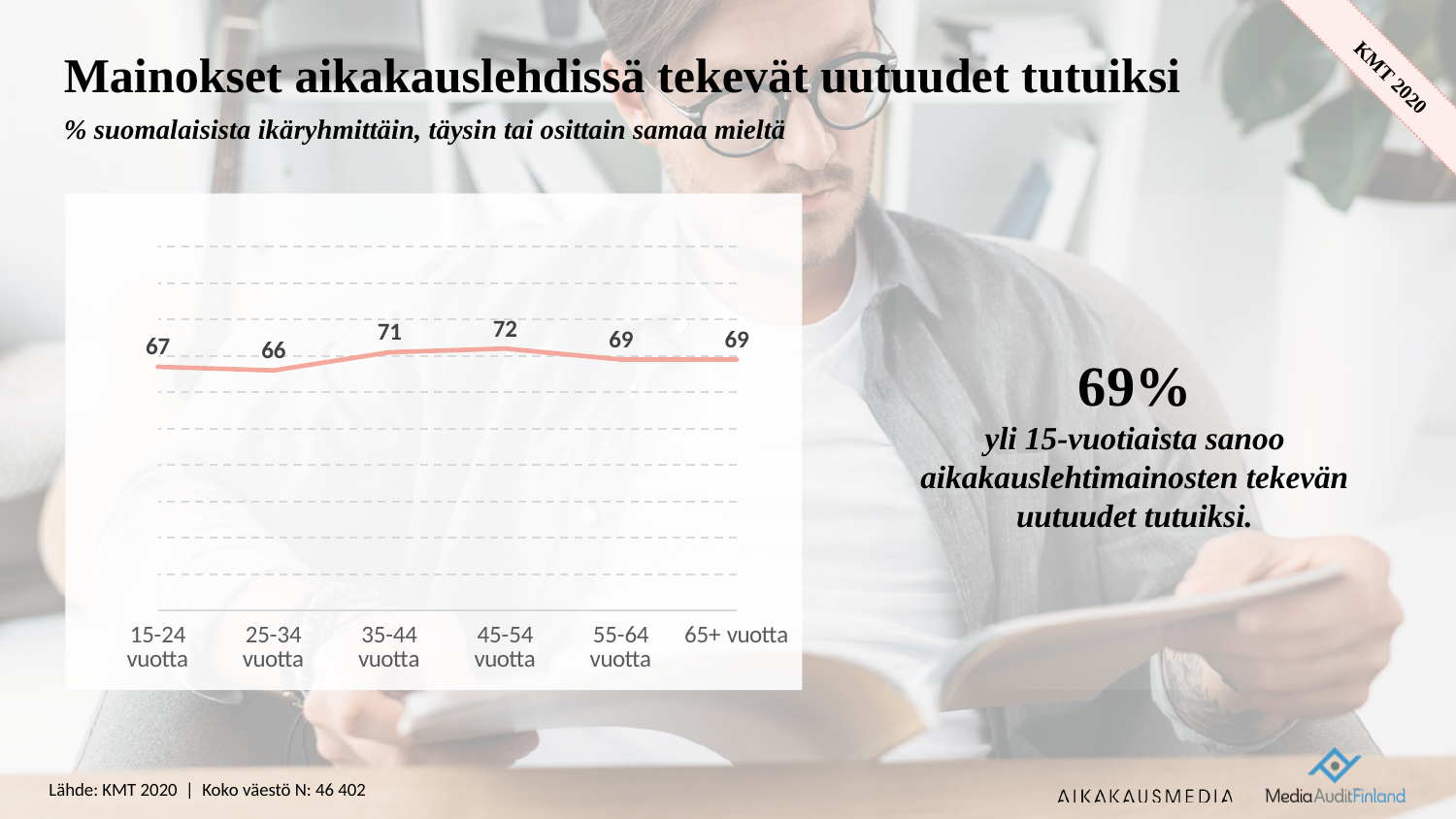
What kind of chart is shown on the slide? Line chart How many age groups are plotted on the chart? 6 Which is larger, the value for 35-44 vuotta or the value for 25-34 vuotta? 35-44 vuotta Which age group has the lowest value? 25-34 vuotta Which age group has the highest value? 45-54 vuotta What is the value for the 45-54 vuotta age group? 72 What is the value for the 15-24 vuotta age group? 67 Does the value rise or fall from 25-34 vuotta to 45-54 vuotta? Rise What is the difference between the values for 45-54 vuotta and 25-34 vuotta? 6 What is the value for the 65+ vuotta age group? 69 What is the title of the chart on the slide? Mainokset aikakauslehdissä tekevät uutuudet tutuiksi What is the difference between the values for 35-44 vuotta and 15-24 vuotta? 4